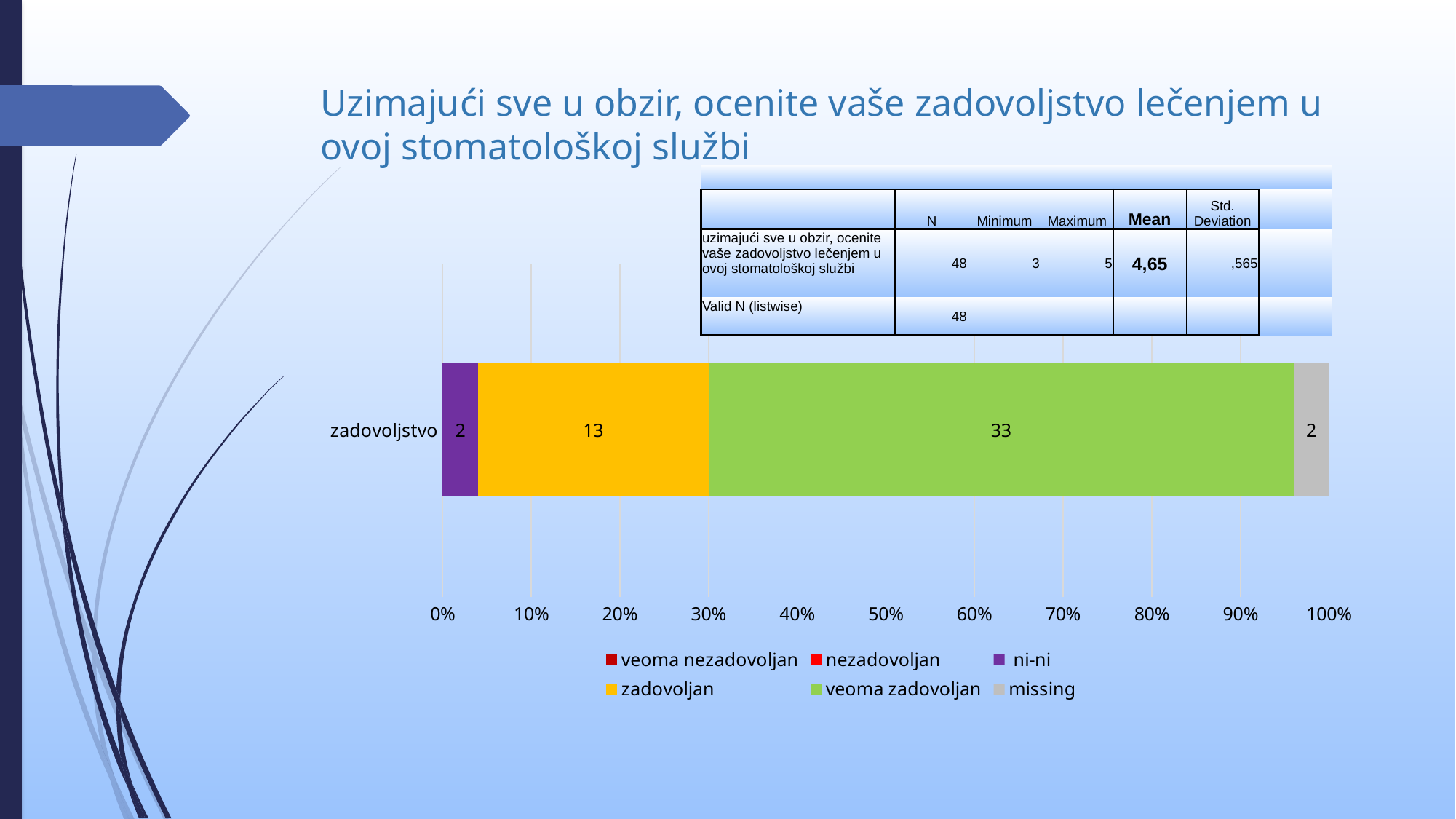
What is the value for "zadovoljan" in the zadovoljstvo bar? 13 What is the total of the labelled segments in the zadovoljstvo bar? 50 How many series does the legend list? 6 What is the difference between the "veoma zadovoljan" and "zadovoljan" values? 20 What is the value for "missing" in the zadovoljstvo bar? 2 What is the value for "veoma zadovoljan" in the zadovoljstvo bar? 33 Which is larger, the "zadovoljan" value or the "ni-ni" value? zadovoljan What colour is the "veoma zadovoljan" segment? green Which series has the largest value in the zadovoljstvo bar? veoma zadovoljan What is the value for "ni-ni" in the zadovoljstvo bar? 2 Does the "veoma zadovoljan" segment end at greater or less than 90% on the axis? greater What kind of chart is shown on the slide? stacked bar chart